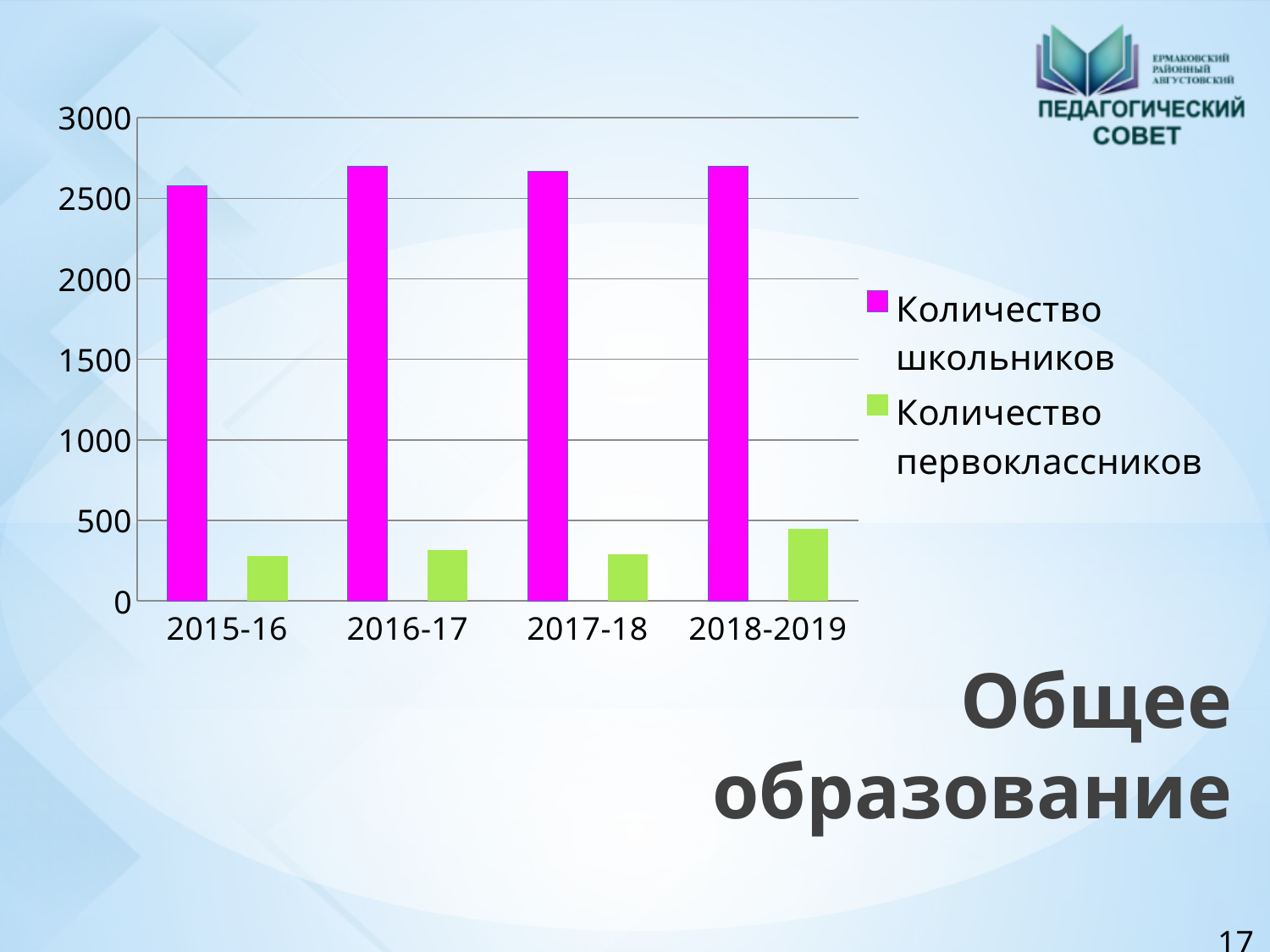
Which is larger: Количество школьников in 2015-16 or in 2016-17? 2016-17 Is the value for Количество первоклассников in 2018-2019 greater or less than 500? less Which school year has the lowest value for Количество школьников? 2015-16 What kind of chart is shown on the slide? bar chart Is the value for Количество школьников in 2015-16 greater or less than 2500? greater What colour are the bars for Количество школьников in the chart? magenta How many series does the chart's legend list? 2 Which school year has the highest value for Количество первоклассников? 2018-2019 Does the value for Количество первоклассников rise or fall from 2017-18 to 2018-2019? rise How many school-year categories are shown on the x axis of the chart? 4 Which is larger: Количество первоклассников in 2016-17 or in 2018-2019? 2018-2019 Is the value for Количество школьников in 2016-17 greater or less than 3000? less